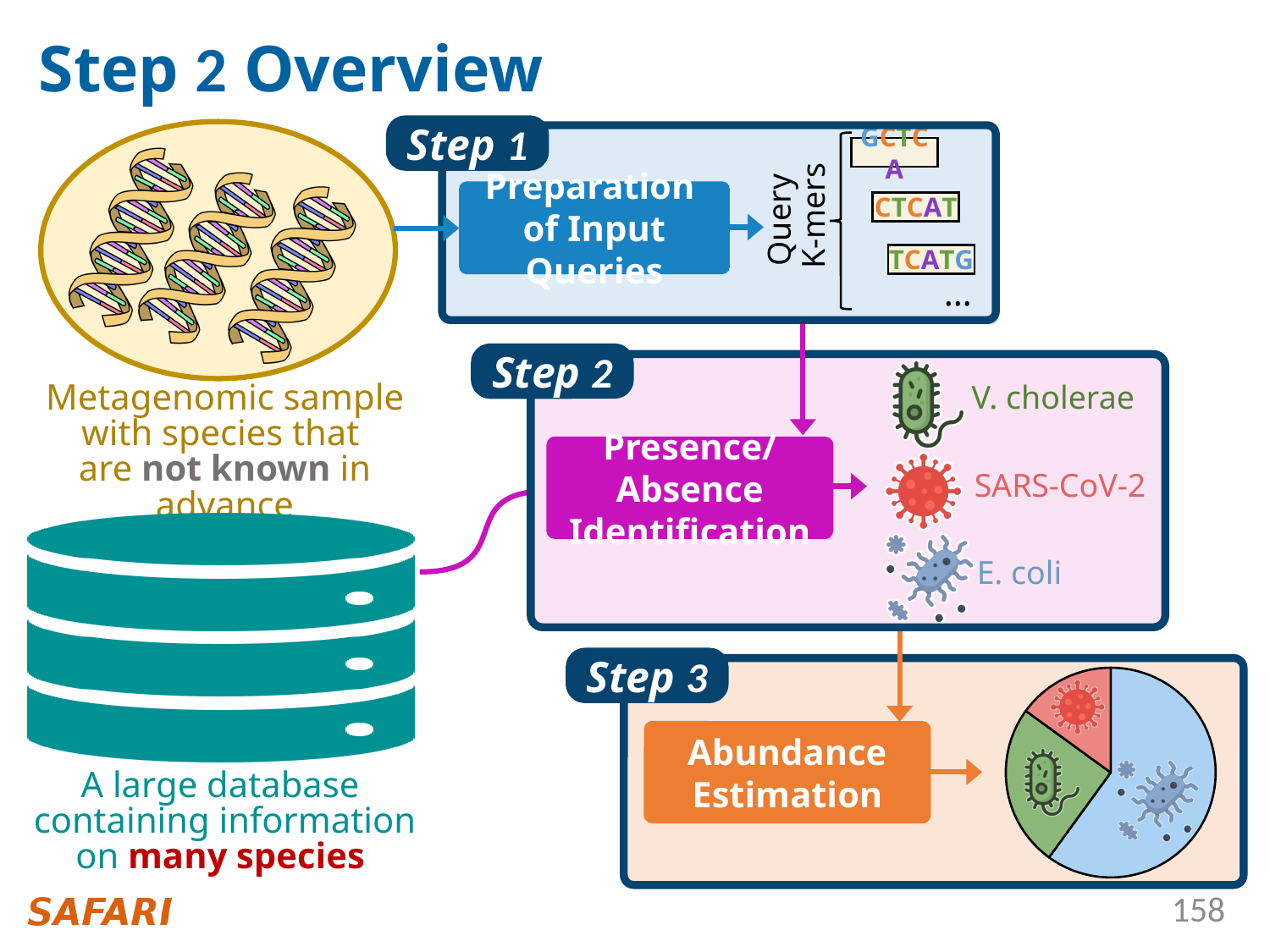
In the pie chart in the Step 3 box, which slice is the largest? the blue slice What kind of chart is shown in the Step 3 box? pie chart What colours are the three slices of the pie chart in the Step 3 box? red, green and blue In the pie chart in the Step 3 box, which is larger, the blue slice or the green slice? the blue slice In the pie chart in the Step 3 box, which is larger, the blue slice or the red slice? the blue slice Does the pie chart in the Step 3 box have a legend? No How many slices does the pie chart in the Step 3 box have? 3